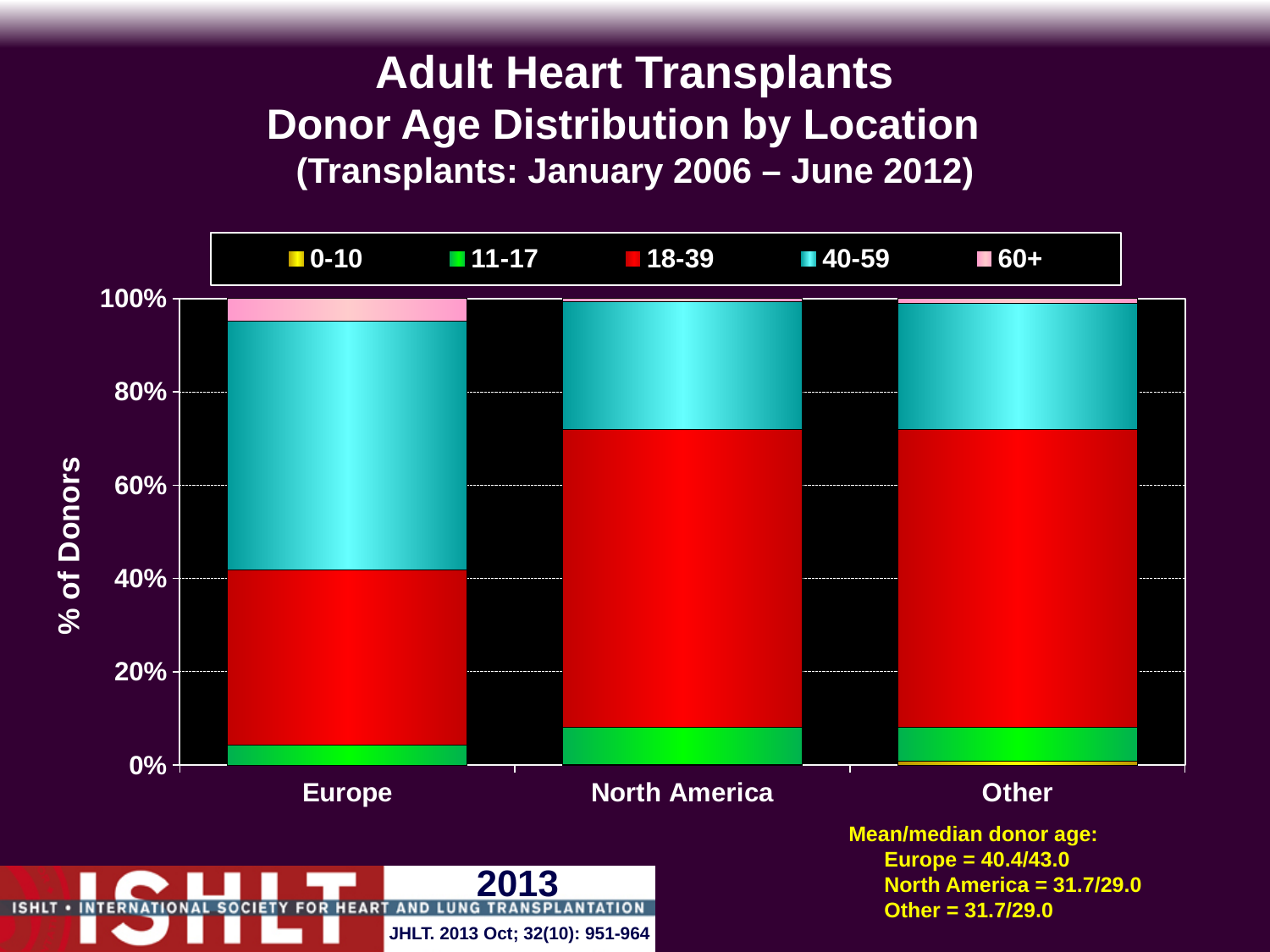
Which location has the smallest share of donors aged 18-39? Europe How many donor age groups does the legend list? 5 What is the label of the y axis? % of Donors Is the share of donors aged 18-39 in North America greater or less than 60%? greater Which location has the largest share of donors aged 60+? Europe According to the text on the slide, what is the mean/median donor age for Europe? 40.4/43.0 Which is larger: the 18-39 share for Europe or the 18-39 share for North America? North America Which location has the largest share of donors aged 40-59? Europe Is the share of donors aged 40-59 in Europe greater or less than 40%? greater Is the share of donors aged 18-39 in Europe greater or less than 60%? less What kind of chart is shown on the slide? stacked bar chart How many locations are shown on the x axis? 3